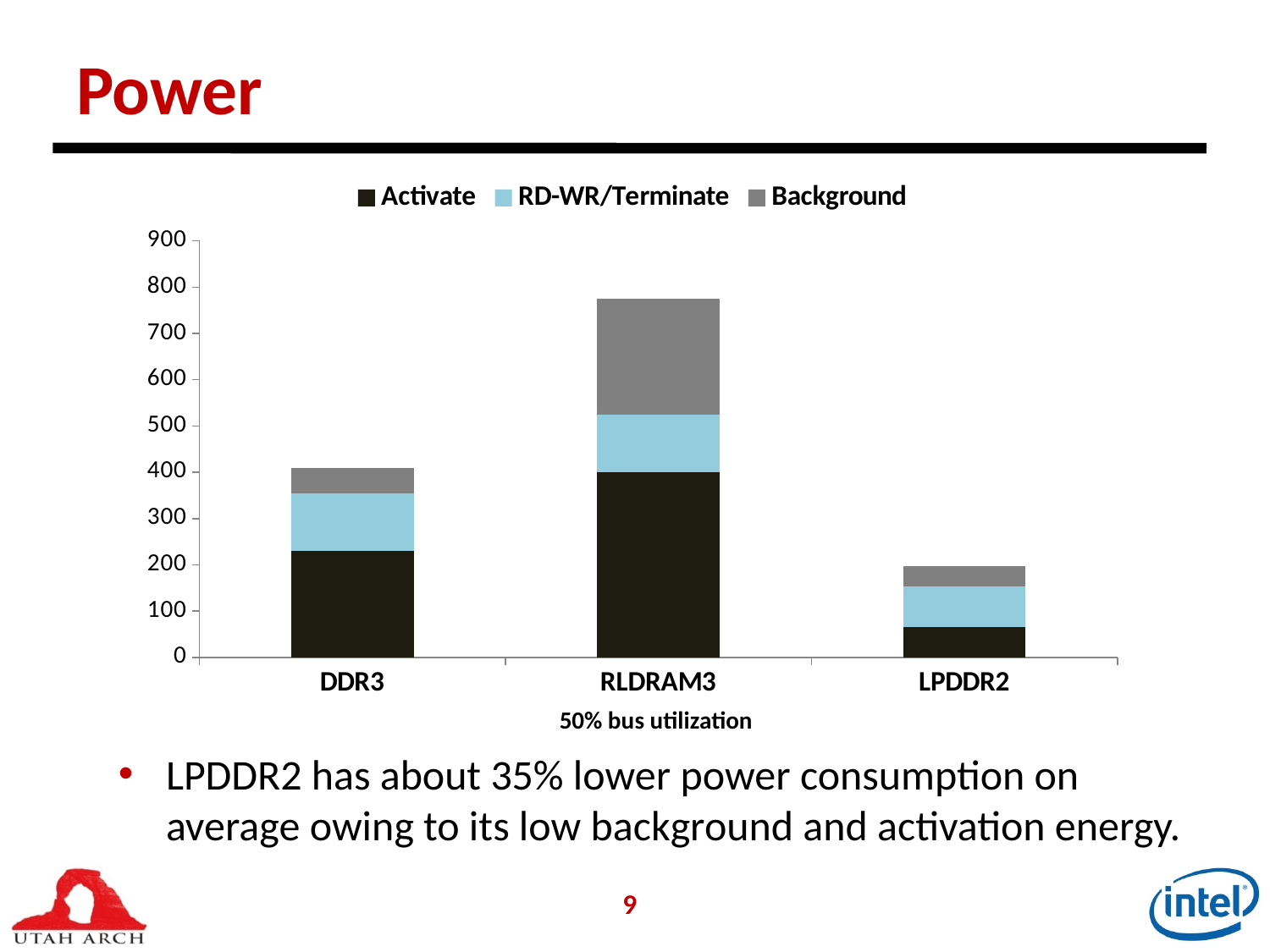
Is the total stacked value for LPDDR2 greater or less than 300? less Which memory type has the lowest total stacked bar in the chart? LPDDR2 Is the total stacked value for DDR3 greater or less than 500? less How many series does the chart's legend list? 3 What label appears below the x axis of the chart? 50% bus utilization Which memory type has the highest total stacked bar in the chart? RLDRAM3 How many memory types (categories) are shown on the x axis of the chart? 3 Is the total stacked value for RLDRAM3 greater or less than 700? greater What kind of chart is shown on the slide? Stacked bar chart Which has a larger total bar, DDR3 or LPDDR2? DDR3